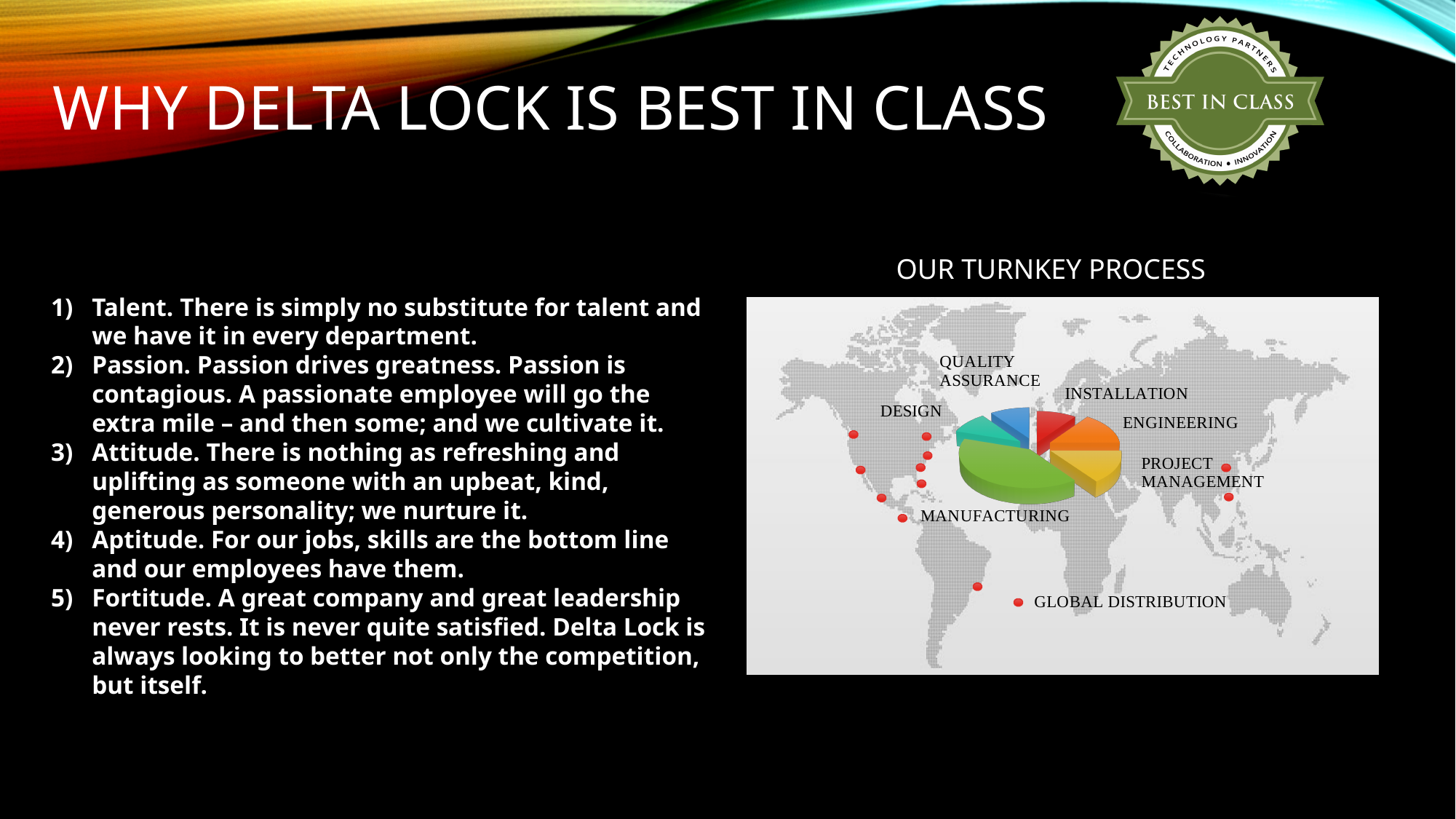
What kind of chart is shown under the heading "OUR TURNKEY PROCESS"? Pie chart In the "OUR TURNKEY PROCESS" pie chart, which is larger, the Manufacturing slice or the Installation slice? Manufacturing What is the title shown above the pie chart on the slide? OUR TURNKEY PROCESS In the "OUR TURNKEY PROCESS" pie chart, which is larger, the Manufacturing slice or the Quality Assurance slice? Manufacturing In the "OUR TURNKEY PROCESS" pie chart, which slice is the largest? Manufacturing In the "OUR TURNKEY PROCESS" pie chart, what colour is the Manufacturing slice? Green